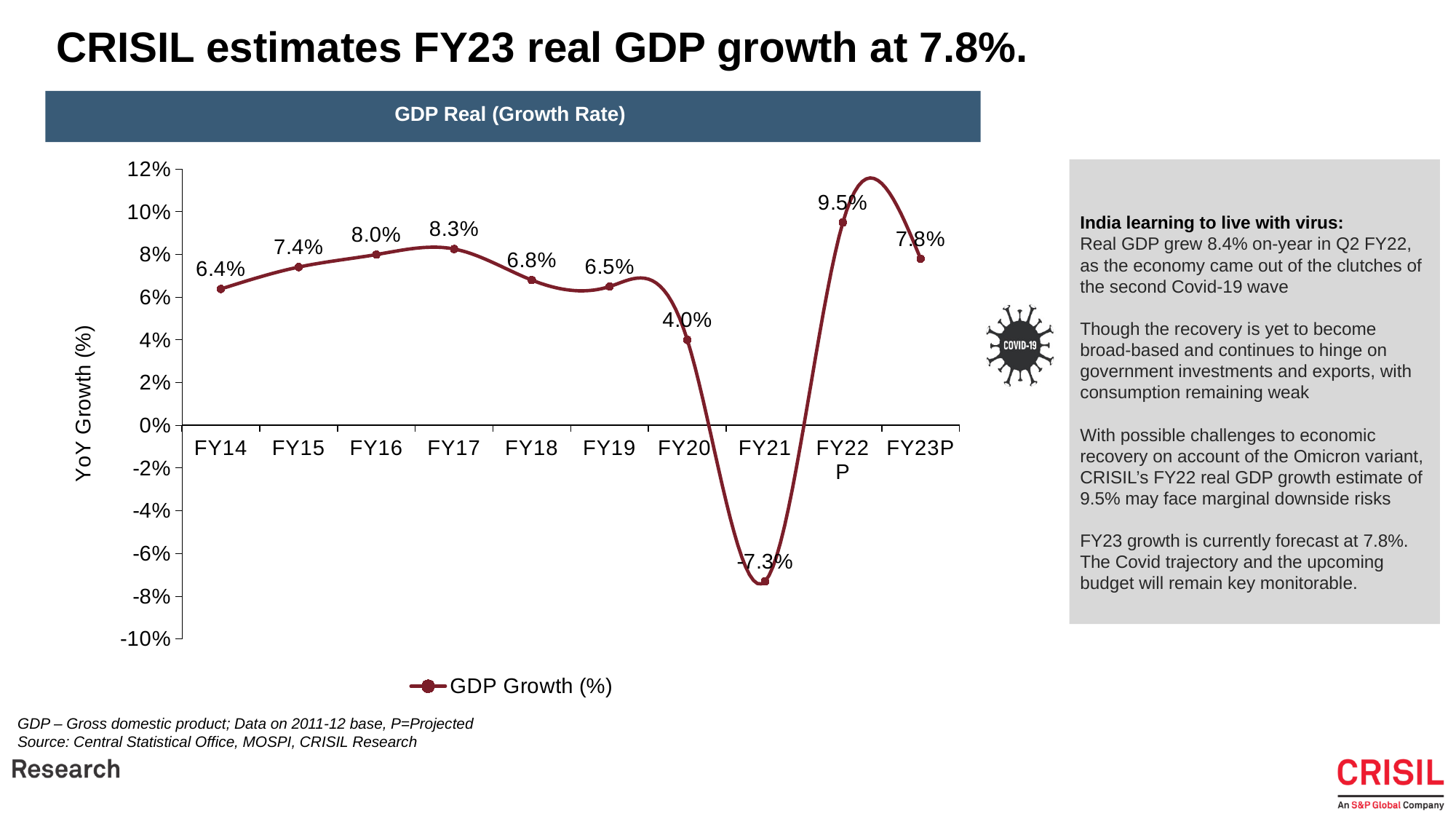
What is the GDP growth value for FY21? -7.3% What is the GDP growth value for FY17? 8.3% Which fiscal year has the lowest GDP growth value? FY21 What kind of chart is shown on the slide? line chart Which is larger, the GDP growth value for FY16 or for FY18? FY16 Which fiscal year has the highest GDP growth value? FY22P Is the GDP growth value for FY20 greater or less than 6%? less What is the title of the chart? GDP Real (Growth Rate) What is the GDP growth value for FY23P? 7.8% What is the difference between the GDP growth values for FY22P and FY23P? 1.7% How many fiscal years are plotted on the x axis? 10 How many series does the legend list? 1